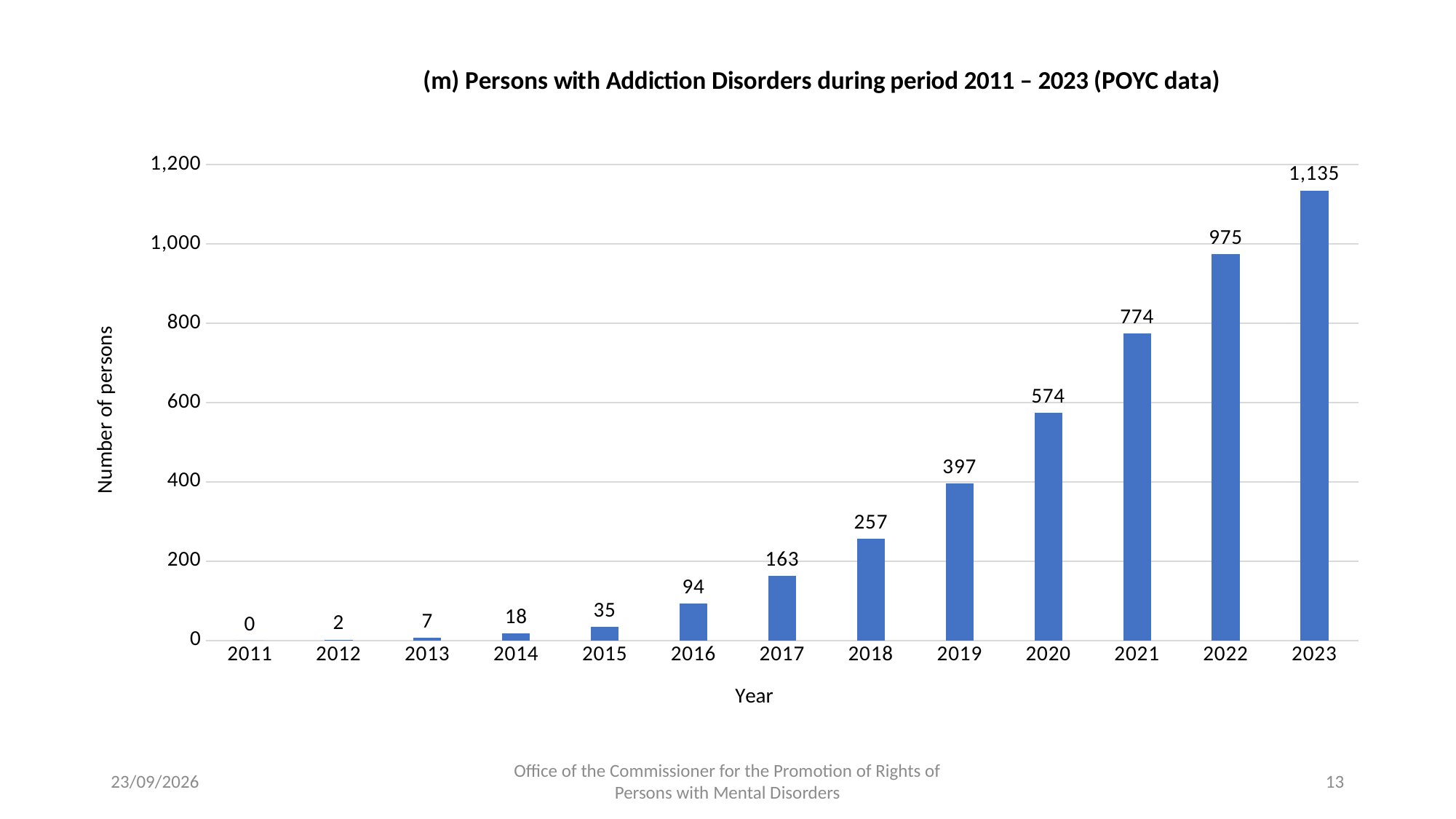
What is the number of persons with addiction disorders in 2016? 94 What is the number of persons with addiction disorders in 2023? 1,135 Which year has the highest number of persons with addiction disorders? 2023 Which year has more persons with addiction disorders, 2017 or 2015? 2017 What is the difference in the number of persons between 2022 and 2021? 201 How many years are shown on the x axis of the chart? 13 What kind of chart is shown on the slide? Bar chart Do the values rise or fall from 2011 to 2023? Rise Is the value for 2021 greater or less than 600? greater What is the difference in the number of persons between 2019 and 2018? 140 Which year has the lowest number of persons with addiction disorders? 2011 What is the number of persons with addiction disorders in 2020? 574